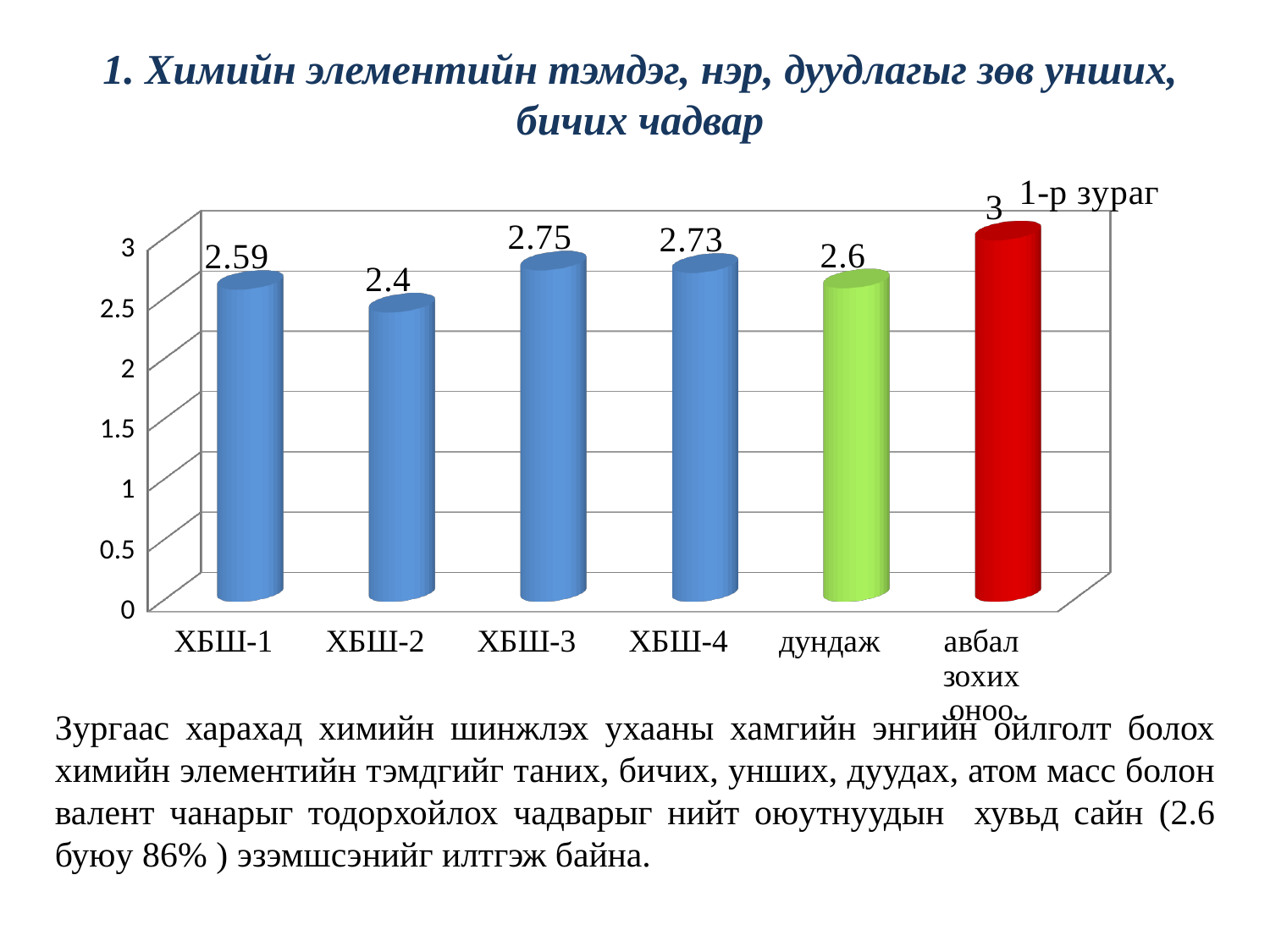
Which is larger, the value for ХБШ-1 or the value for ХБШ-2? ХБШ-1 What is the difference between the value for авбал зохих оноо and the value for дундаж? 0.4 Is the value for ХБШ-4 greater or less than 2.5? greater What kind of chart is shown on the slide? bar chart What is the difference between the values for ХБШ-3 and ХБШ-2? 0.35 What is the value for ХБШ-2? 2.4 Which category has the highest value? авбал зохих оноо What is the value for дундаж? 2.6 How many categories are shown on the x axis? 6 What is the value for ХБШ-1? 2.59 Which category has the lowest value? ХБШ-2 What is the value for ХБШ-3? 2.75